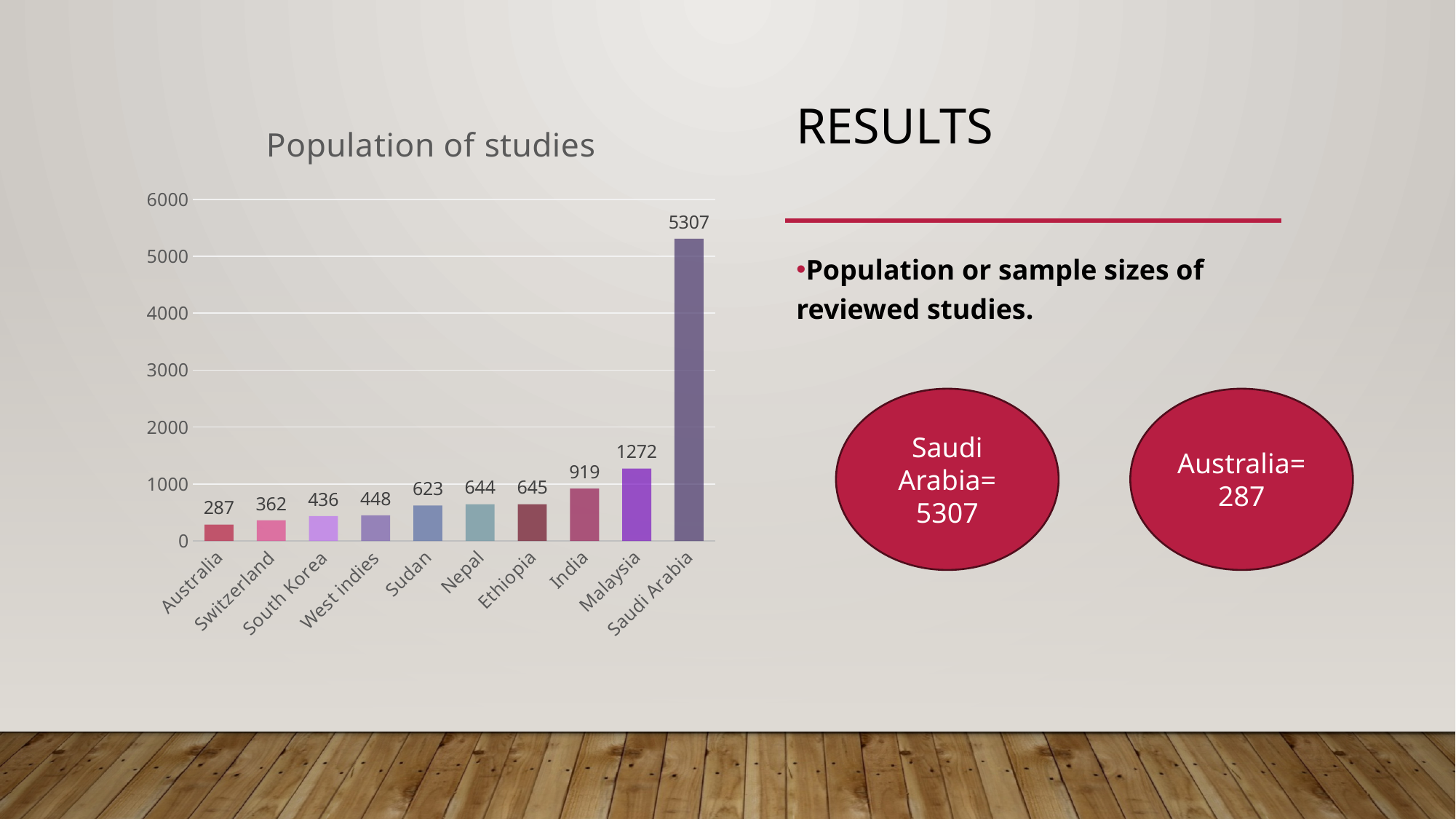
What kind of chart is the Population of studies chart? bar chart What is the difference between the values for India and Australia? 632 What is the value for West indies in the Population of studies chart? 448 Which country has the lowest value in the Population of studies chart? Australia What is the title of the chart on the slide? Population of studies Which country has the highest value in the Population of studies chart? Saudi Arabia What is the value for Sudan in the Population of studies chart? 623 What is the value for Malaysia in the Population of studies chart? 1272 Is the value for India greater or less than 1000? less How many countries are shown in the Population of studies chart? 10 Which has a larger value, Switzerland or South Korea? South Korea What is the difference between the values for Saudi Arabia and Malaysia? 4035